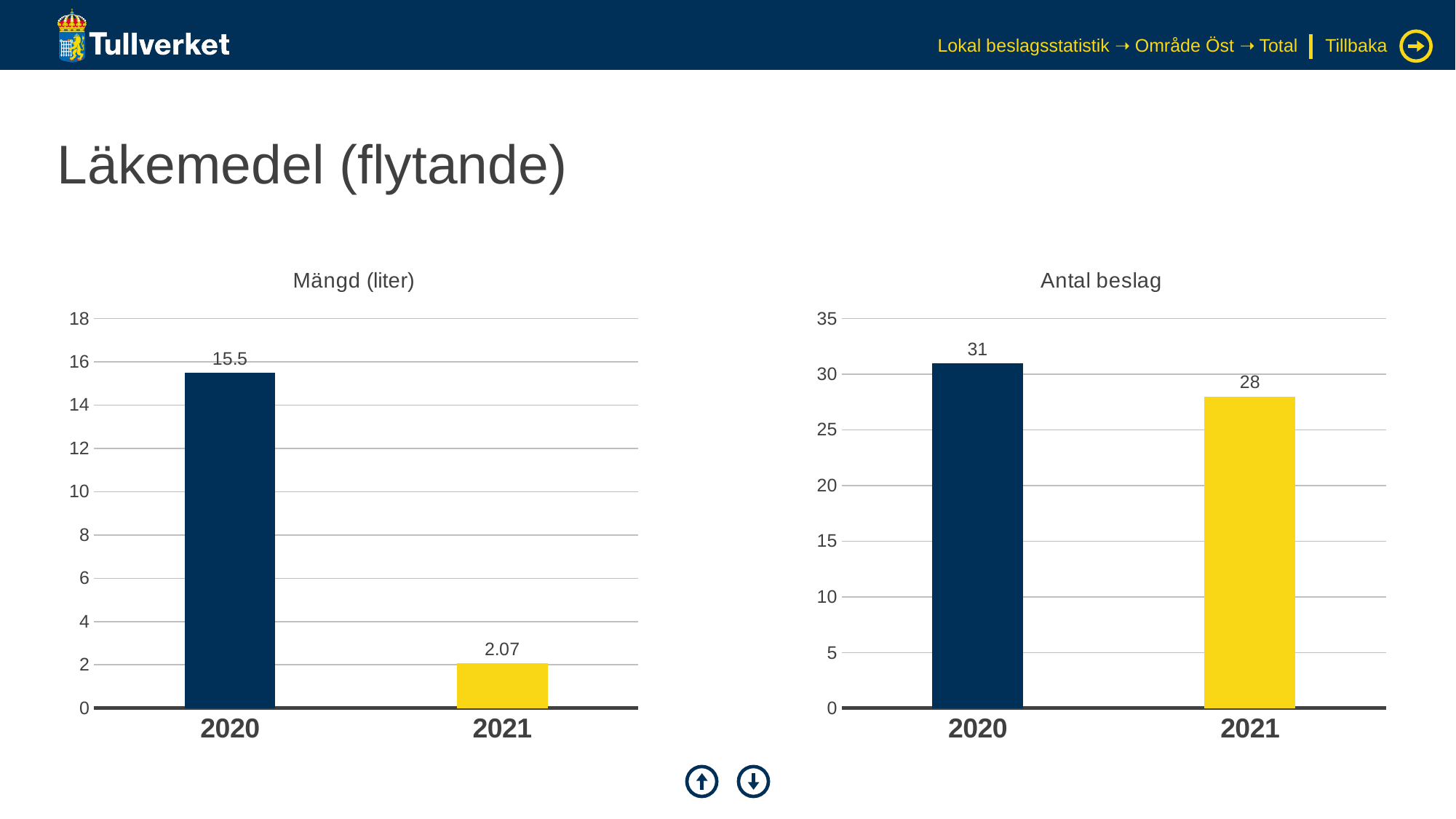
In the 'Antal beslag' chart, is the value for 2021 greater or less than 25? greater In the 'Antal beslag' chart, what is the difference between the 2020 and 2021 values? 3 In the 'Mängd (liter)' chart, what is the value for 2021? 2.07 How many categories does the 'Mängd (liter)' chart show? 2 In the 'Antal beslag' chart, what is the value for 2021? 28 In the 'Mängd (liter)' chart, which year has the highest value? 2020 In the 'Antal beslag' chart, what is the value for 2020? 31 What kind of chart is the 'Antal beslag' chart? bar chart In the 'Mängd (liter)' chart, which is larger, the value for 2020 or 2021? 2020 In the 'Antal beslag' chart, which year has the lowest value? 2021 In the 'Mängd (liter)' chart, what is the value for 2020? 15.5 In the 'Antal beslag' chart, do the values rise or fall from 2020 to 2021? fall